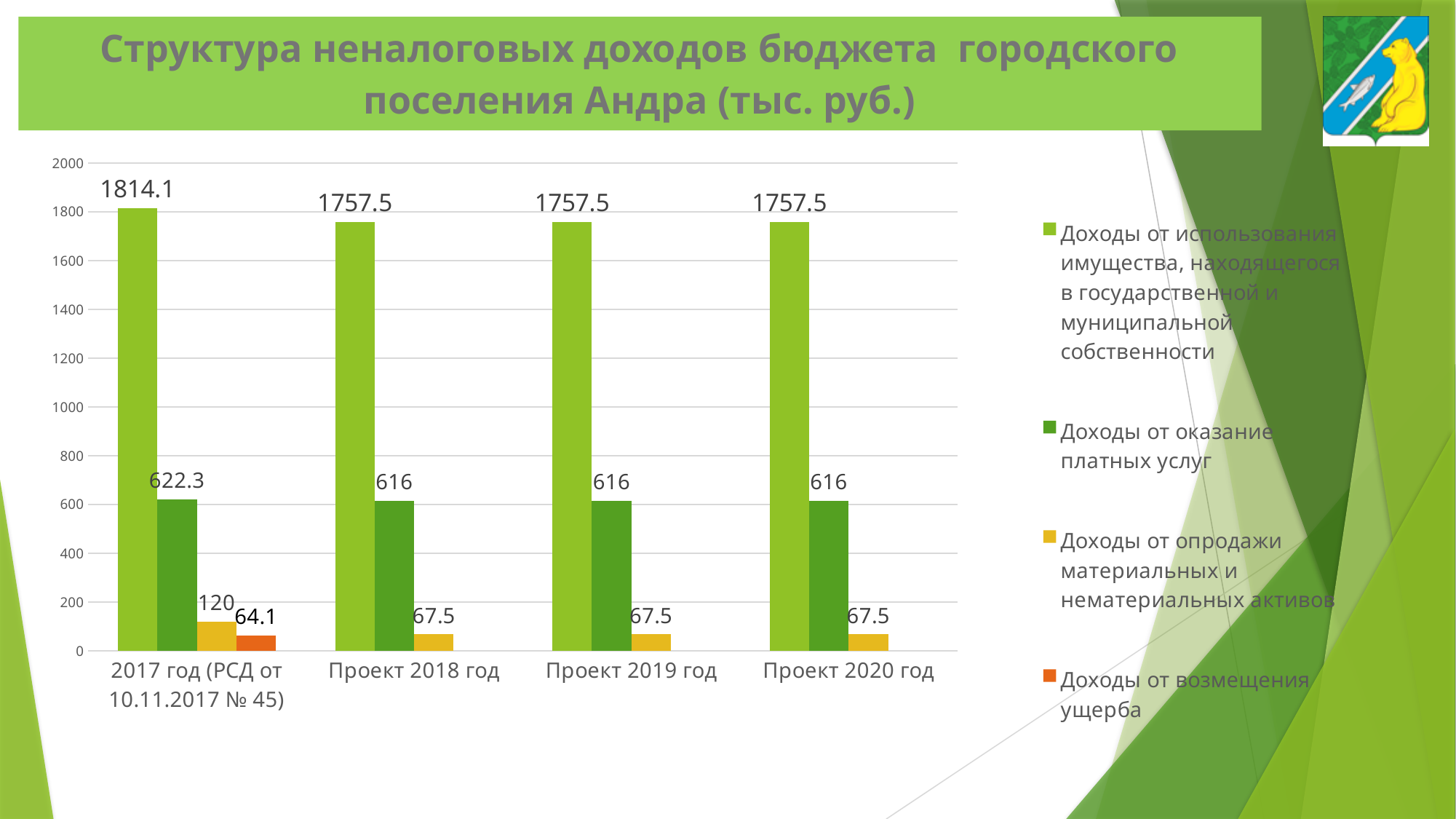
What is the value of 'Доходы от возмещения ущерба' for '2017 год (РСД от 10.11.2017 № 45)'? 64.1 Which is larger: 'Доходы от опродажи материальных и нематериальных активов' for '2017 год (РСД от 10.11.2017 № 45)' or for 'Проект 2018 год'? 2017 год (РСД от 10.11.2017 № 45) What is the difference between the 'Доходы от оказание платных услуг' values for '2017 год (РСД от 10.11.2017 № 45)' and 'Проект 2018 год'? 6.3 In which category is 'Доходы от использования имущества, находящегося в государственной и муниципальной собственности' highest? 2017 год (РСД от 10.11.2017 № 45) What kind of chart is shown on the slide? bar chart How many series does the legend list? 4 What is the difference between the 'Доходы от использования имущества, находящегося в государственной и муниципальной собственности' values for '2017 год (РСД от 10.11.2017 № 45)' and 'Проект 2019 год'? 56.6 How many categories are shown on the x axis? 4 What is the value of 'Доходы от оказание платных услуг' for 'Проект 2019 год'? 616 What is the value of 'Доходы от использования имущества, находящегося в государственной и муниципальной собственности' for '2017 год (РСД от 10.11.2017 № 45)'? 1814.1 What is the value of 'Доходы от опродажи материальных и нематериальных активов' for 'Проект 2020 год'? 67.5 Does 'Доходы от использования имущества, находящегося в государственной и муниципальной собственности' rise or fall from '2017 год (РСД от 10.11.2017 № 45)' to 'Проект 2018 год'? fall